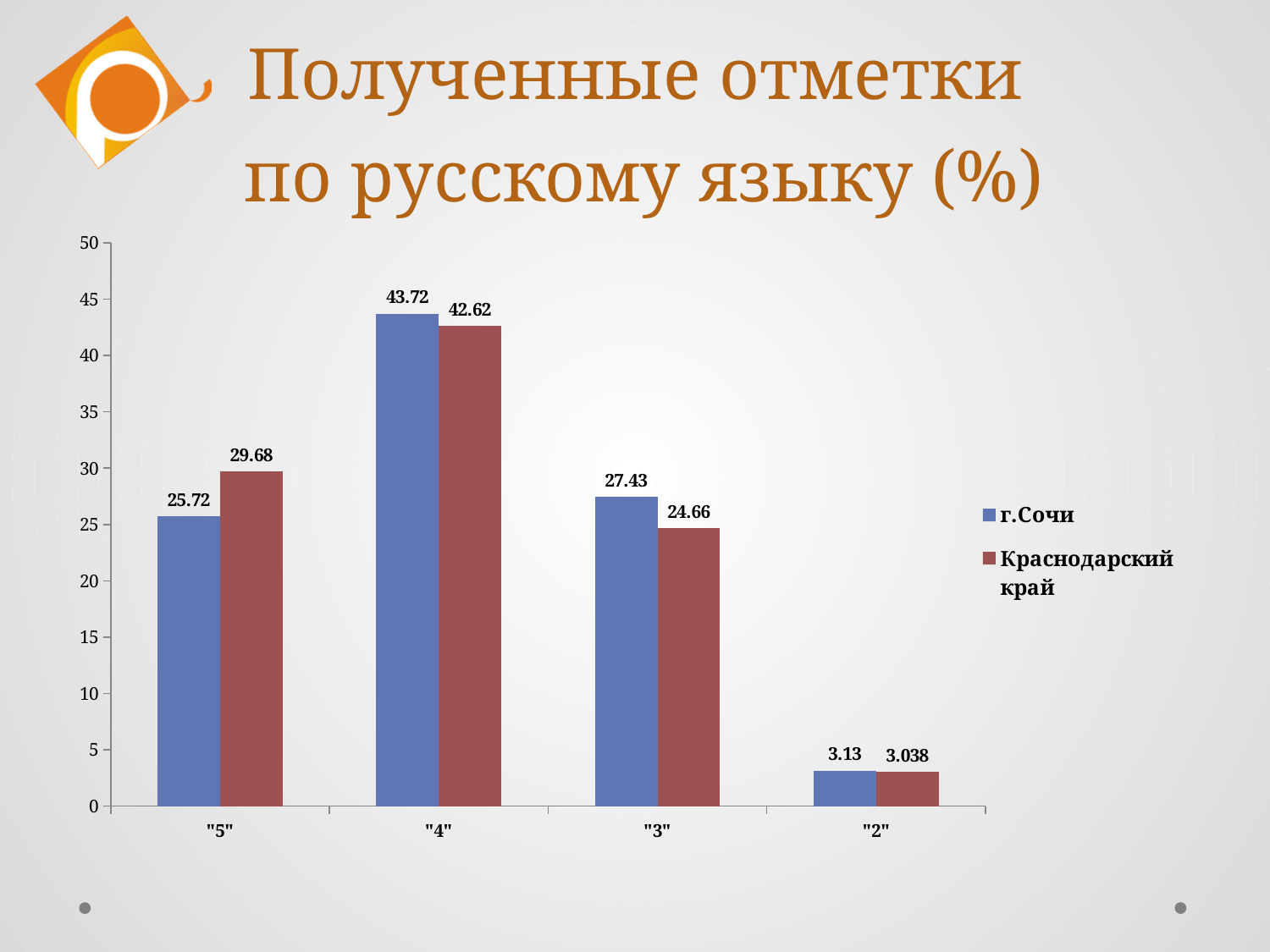
What is the value for г.Сочи for the "2" category? 3.13 What is the value for г.Сочи for the "4" category? 43.72 What is the value for Краснодарский край for the "3" category? 24.66 Which is larger for the "5" category: г.Сочи or Краснодарский край? Краснодарский край Which category has the lowest value for Краснодарский край? "2" What is the difference between г.Сочи and Краснодарский край for the "3" category? 2.77 What is the value for Краснодарский край for the "5" category? 29.68 How many series does the legend list? 2 How many categories are shown on the x axis? 4 Is the value for г.Сочи in the "4" category greater or less than 40? greater Which category has the highest value for г.Сочи? "4" What kind of chart is shown on the slide? bar chart